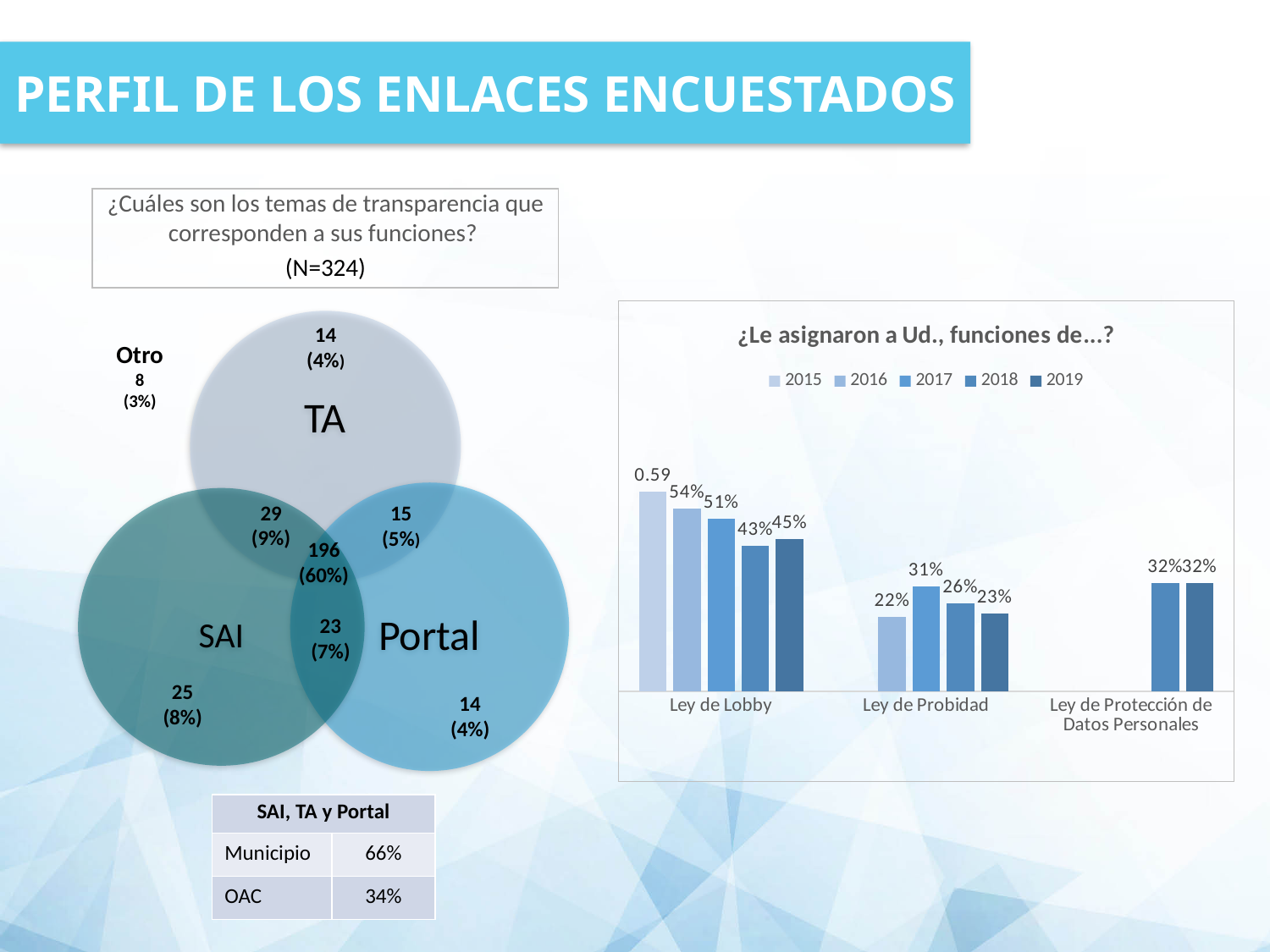
In the bar chart "¿Le asignaron a Ud., funciones de...?", what is the value for 2019 in Ley de Lobby? 45% In the bar chart "¿Le asignaron a Ud., funciones de...?", what is the value for 2016 in Ley de Lobby? 54% In the bar chart "¿Le asignaron a Ud., funciones de...?", which is larger: the 2019 value for Ley de Lobby or the 2019 value for Ley de Protección de Datos Personales? Ley de Lobby In the bar chart "¿Le asignaron a Ud., funciones de...?", what is the value labelled for 2015 in Ley de Lobby? 0.59 In the bar chart "¿Le asignaron a Ud., funciones de...?", what is the difference between the 2016 and 2017 values for Ley de Lobby? 3% What is the title of the bar chart on the right of the slide? ¿Le asignaron a Ud., funciones de...? In the bar chart "¿Le asignaron a Ud., funciones de...?", how many series does the legend list? 5 In the bar chart "¿Le asignaron a Ud., funciones de...?", what value is shown for both bars in Ley de Protección de Datos Personales? 32% In the bar chart "¿Le asignaron a Ud., funciones de...?", which year has the highest value for Ley de Lobby? 2015 In the bar chart "¿Le asignaron a Ud., funciones de...?", how many categories are shown on the x axis? 3 What kind of chart is shown under the title "¿Le asignaron a Ud., funciones de...?"? bar chart In the bar chart "¿Le asignaron a Ud., funciones de...?", what is the highest value shown for Ley de Probidad? 31%